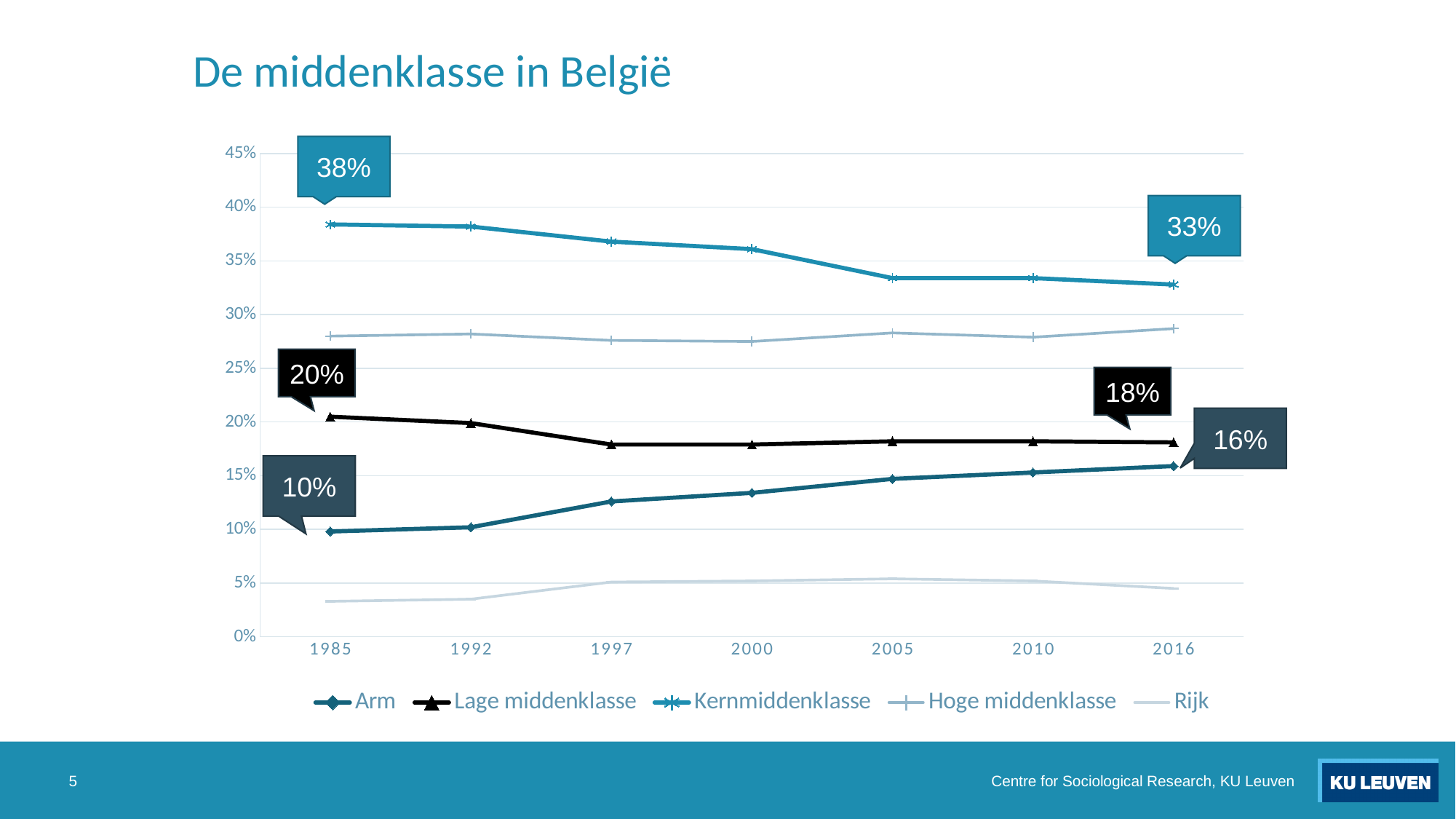
What is the value for Kernmiddenklasse in 1985? 38% What is the value for Arm in 2016? 16% Is the value for Hoge middenklasse in 2016 greater or less than 25%? greater How many years are shown on the x axis? 7 What kind of chart is shown on the slide? line chart What is the value for Arm in 1985? 10% What is the value for Kernmiddenklasse in 2016? 33% How many series does the legend list? 5 What is the value for Lage middenklasse in 2016? 18% Does the Arm series rise or fall from 1985 to 2016? rise Which series has the highest value in 1985? Kernmiddenklasse By how many percentage points did Kernmiddenklasse fall between 1985 and 2016? 5 percentage points